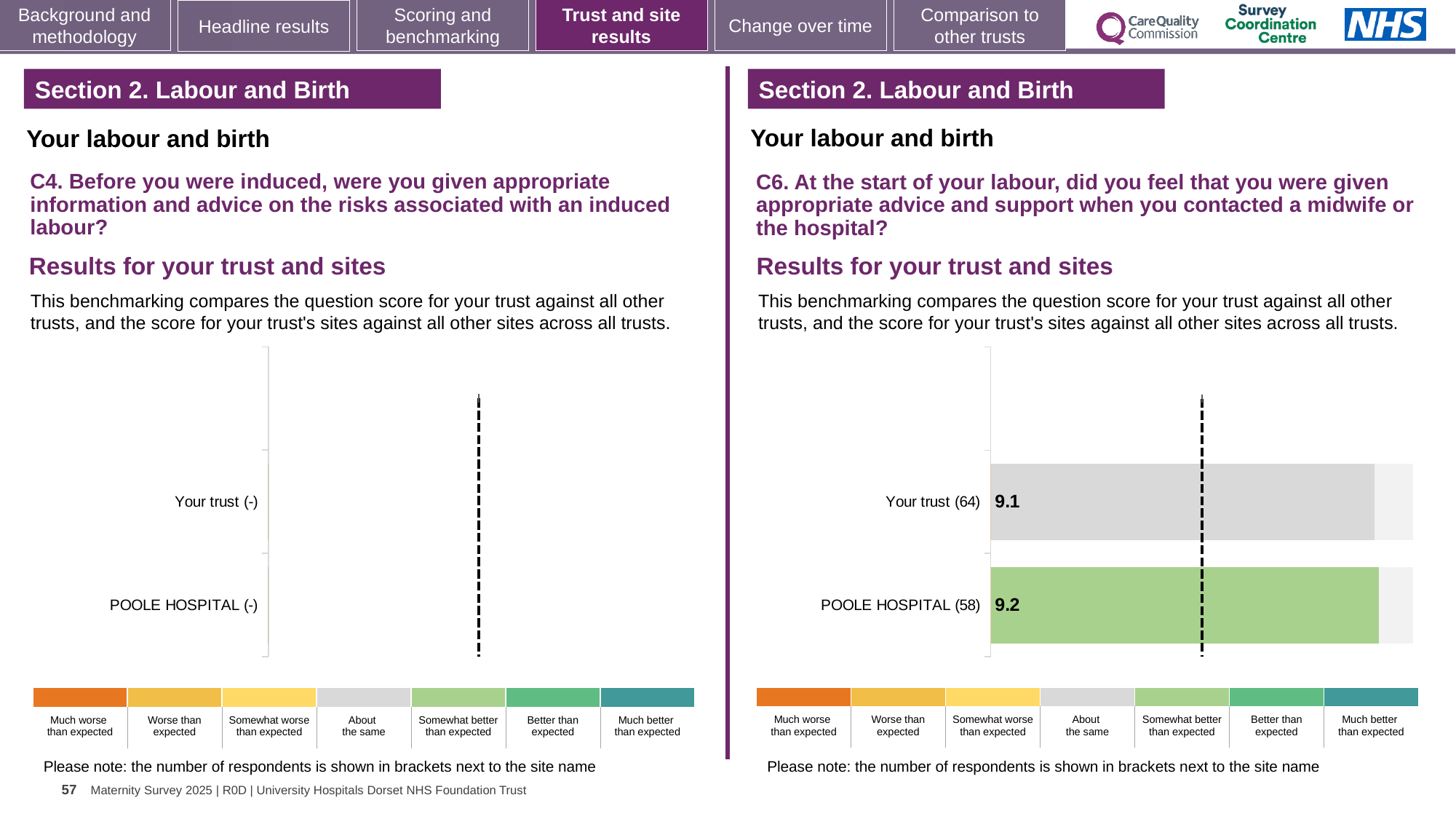
In the right-hand chart (C6), which benchmark category does the colour of the Your trust bar correspond to? About the same In the left-hand chart (C4), what is shown in brackets next to Your trust? - In the right-hand chart (C6), what is the score for POOLE HOSPITAL? 9.2 How many categories are listed in the colour key below the right-hand chart (C6)? 7 How many bars are plotted in the right-hand chart (C6)? 2 In the right-hand chart (C6), how many respondents are shown in brackets for POOLE HOSPITAL? 58 In the right-hand chart (C6), how many respondents are shown in brackets for Your trust? 64 What type of chart is used in the right-hand chart (C6)? Bar chart In the right-hand chart (C6), which benchmark category does the colour of the POOLE HOSPITAL bar correspond to? Somewhat better than expected In the right-hand chart (C6), what is the score for Your trust? 9.1 In the right-hand chart (C6), which has the higher score, Your trust or POOLE HOSPITAL? POOLE HOSPITAL In the right-hand chart (C6), what is the difference between the POOLE HOSPITAL score and the Your trust score? 0.1